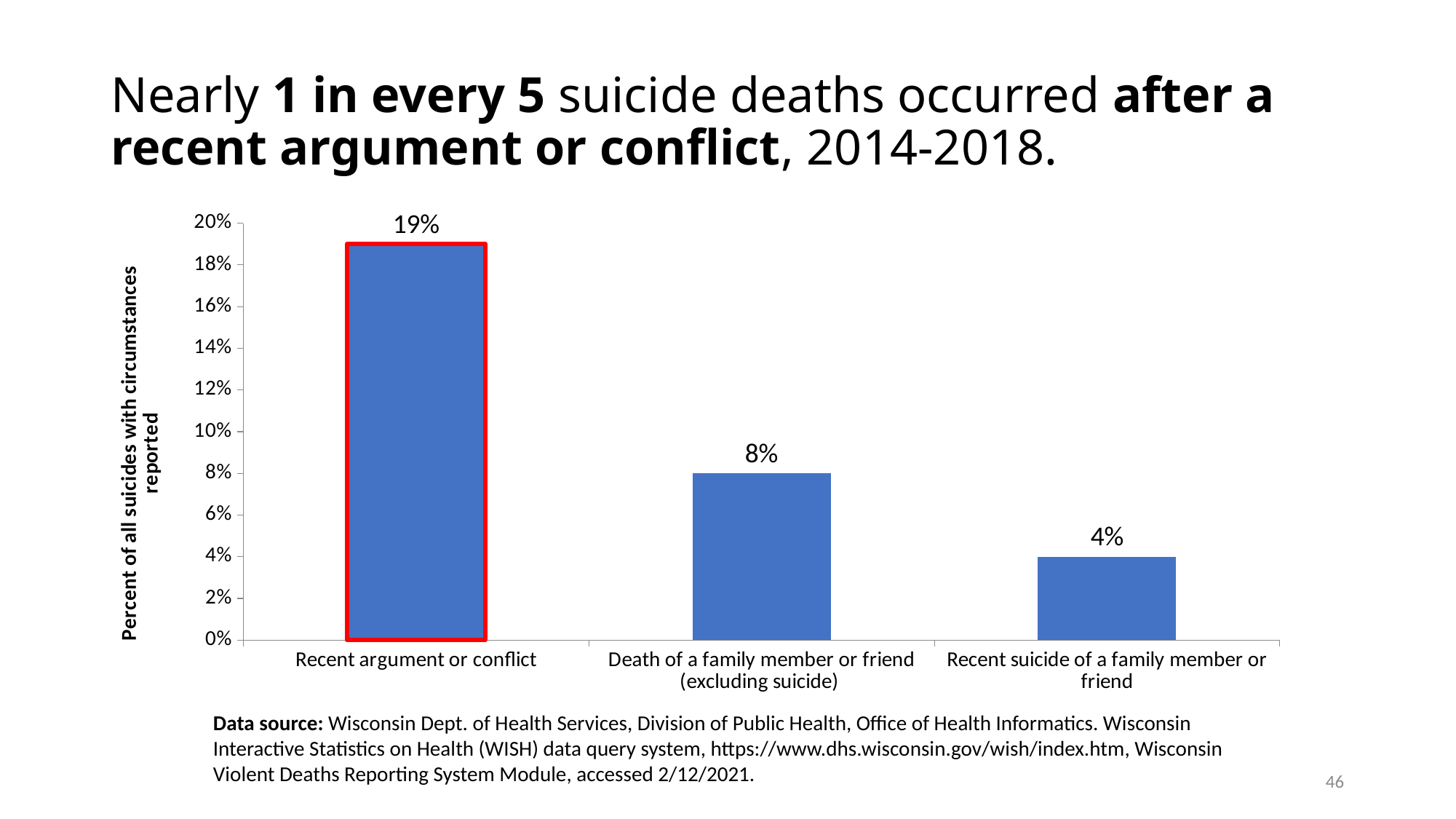
Is the value for 'Recent argument or conflict' greater or less than 10%? greater What is the value for 'Death of a family member or friend (excluding suicide)'? 8% What percent of suicides had a recent argument or conflict reported as a circumstance? 19% Which category has the highest percentage? Recent argument or conflict What is the value for 'Recent suicide of a family member or friend'? 4% What is the difference in percentage points between 'Recent argument or conflict' and 'Death of a family member or friend (excluding suicide)'? 11 percentage points How many categories are shown in the chart? 3 Which is larger: the value for 'Death of a family member or friend (excluding suicide)' or 'Recent suicide of a family member or friend'? Death of a family member or friend (excluding suicide) What is the difference between the values for 'Death of a family member or friend (excluding suicide)' and 'Recent suicide of a family member or friend'? 4 percentage points Which category has the lowest percentage? Recent suicide of a family member or friend Which bar is outlined in red? Recent argument or conflict What type of chart is shown on the slide? Bar chart